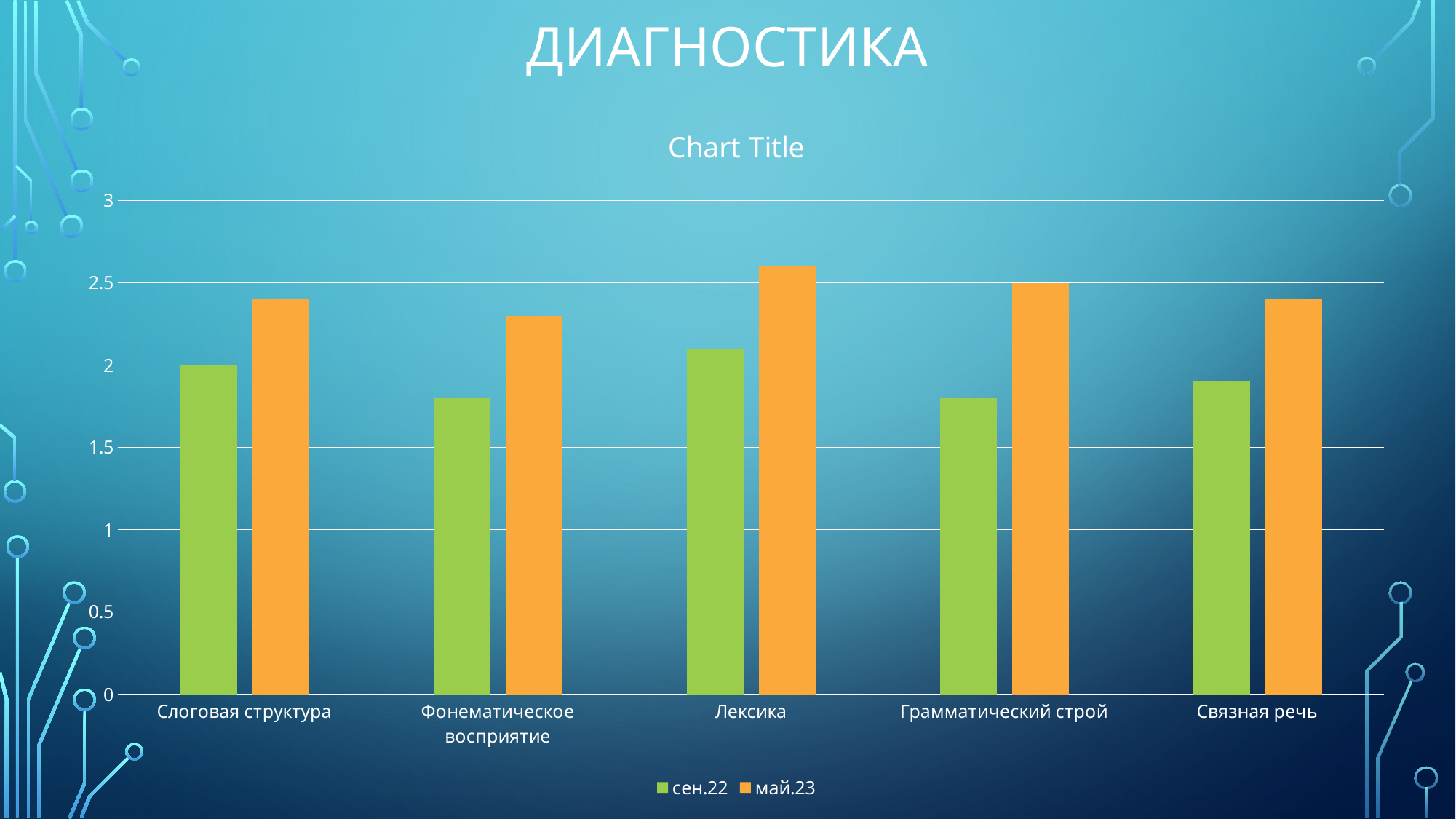
For Грамматический строй, which series has the larger value, сен.22 or май.23? май.23 What are the two series named in the legend? сен.22 and май.23 What colour are the bars for the май.23 series? orange Is the value for Связная речь in the май.23 series greater or less than 2? greater Is the value for Лексика in the май.23 series greater or less than 2.5? greater Is the value for Фонематическое восприятие in the сен.22 series greater or less than 2? less How many categories are shown on the x axis of the chart? 5 Which category has the highest value in the май.23 series? Лексика What kind of chart is shown on the slide? bar chart What is the value for Слоговая структура in the сен.22 series? 2 What is the value for Грамматический строй in the май.23 series? 2.5 How many series does the chart's legend list? 2